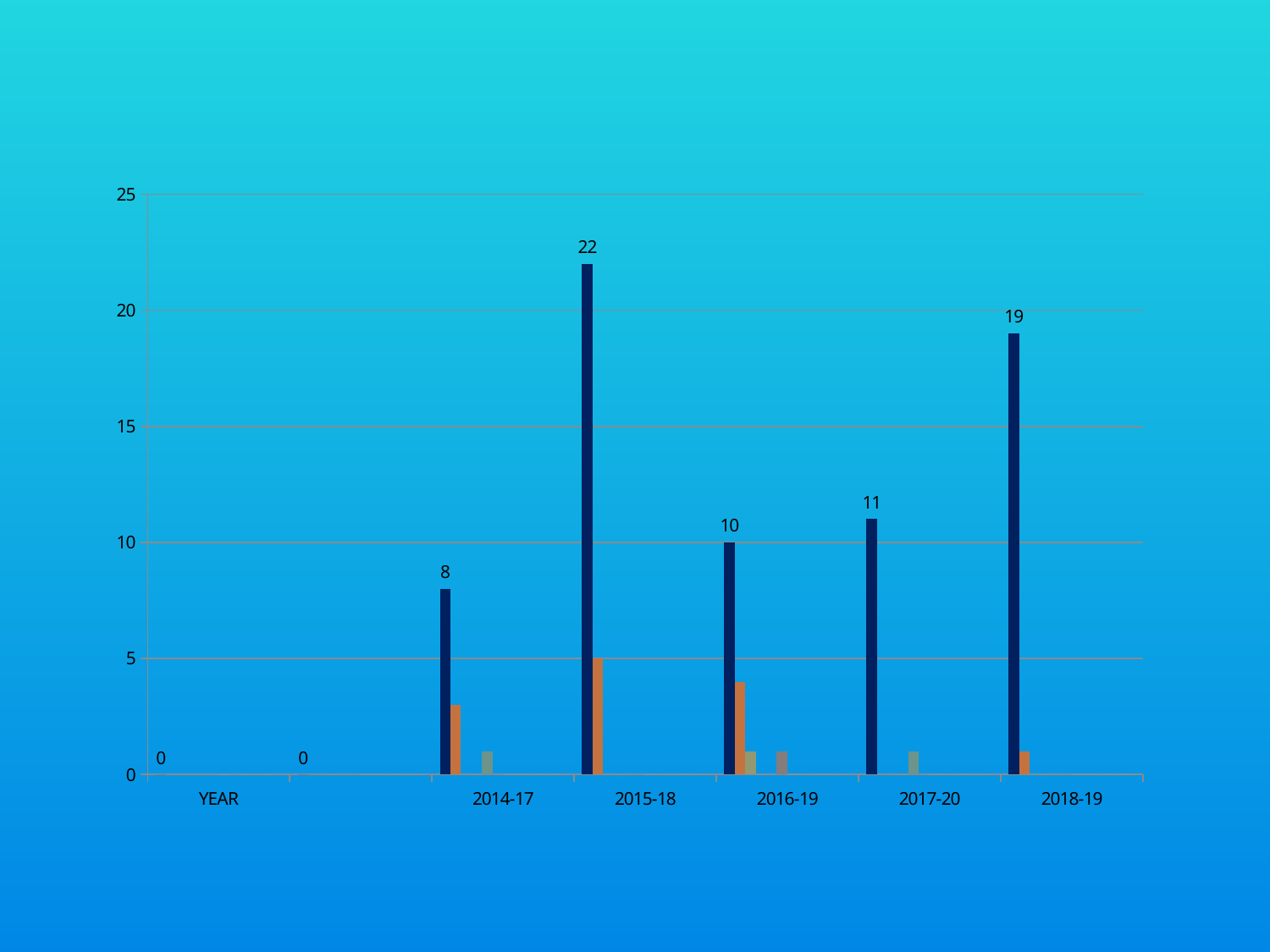
What kind of chart is shown on the slide? bar chart What is the difference between the dark blue bar values for 2018-19 and 2017-20? 8 What is the value of the dark blue bar for 2014-17? 8 Do the dark blue bar values rise or fall from 2016-19 to 2018-19? rise What is the value of the dark blue bar for 2017-20? 11 What is the value of the dark blue bar for 2018-19? 19 What is the difference between the dark blue bar values for 2015-18 and 2014-17? 14 Which category has the highest dark blue bar? 2015-18 What is the highest value shown on the vertical axis? 25 Which has the larger dark blue bar, 2016-19 or 2018-19? 2018-19 What is the value of the dark blue bar for 2015-18? 22 Is the value of the orange bar for 2014-17 greater or less than 5? less